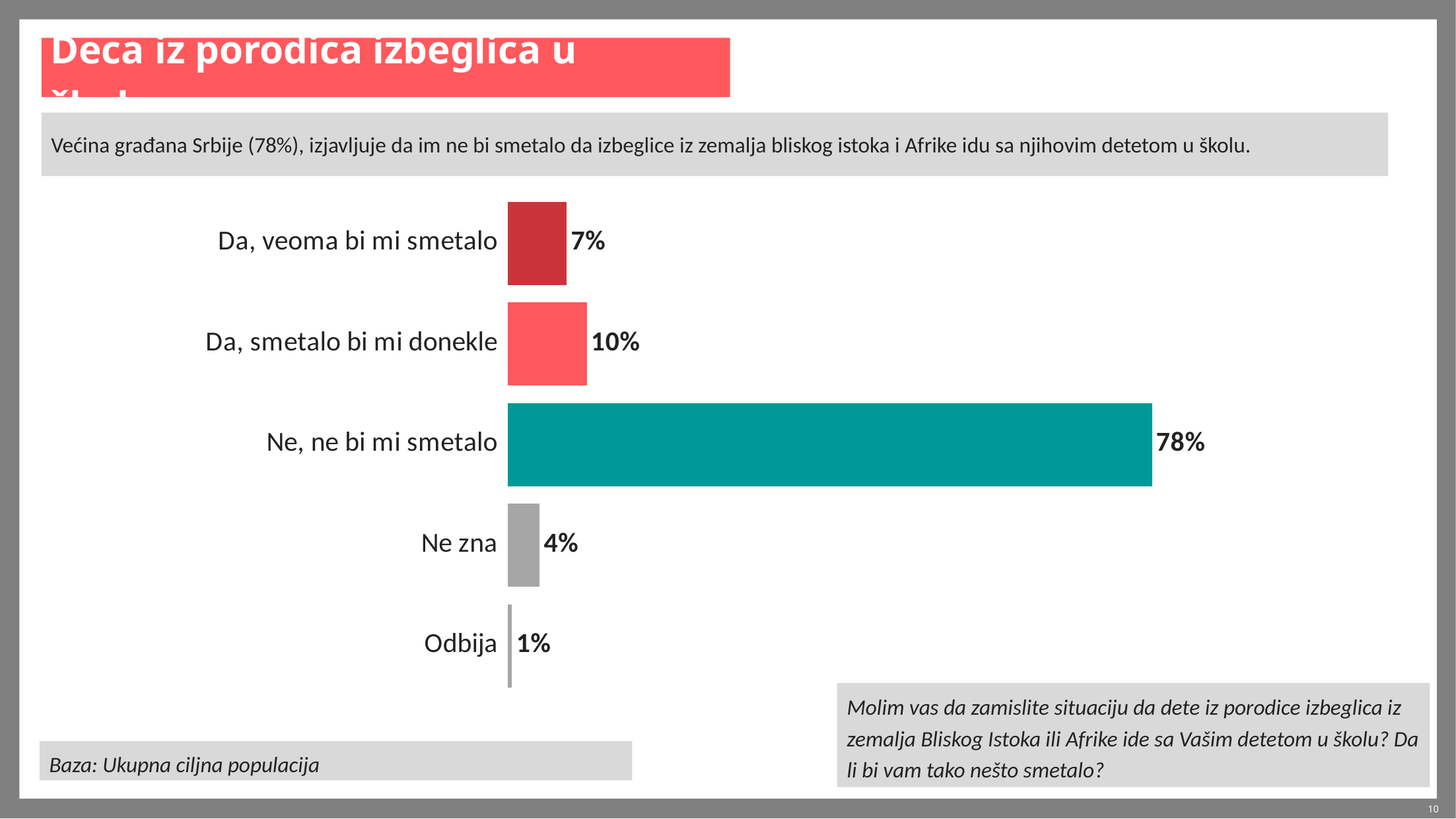
What is the value for "Da, smetalo bi mi donekle"? 10% What is the value for "Odbija"? 1% How many categories are shown in the chart? 5 Which category has the highest value? Ne, ne bi mi smetalo What colour is the bar for "Ne, ne bi mi smetalo"? Teal Which category has the lowest value? Odbija What is the value for "Da, veoma bi mi smetalo"? 7% What kind of chart is shown on the slide? Bar chart What is the value for "Ne, ne bi mi smetalo"? 78% What is the value for "Ne zna"? 4% Which is larger, "Da, veoma bi mi smetalo" or "Da, smetalo bi mi donekle"? Da, smetalo bi mi donekle What is the difference between "Ne, ne bi mi smetalo" and "Da, smetalo bi mi donekle"? 68%